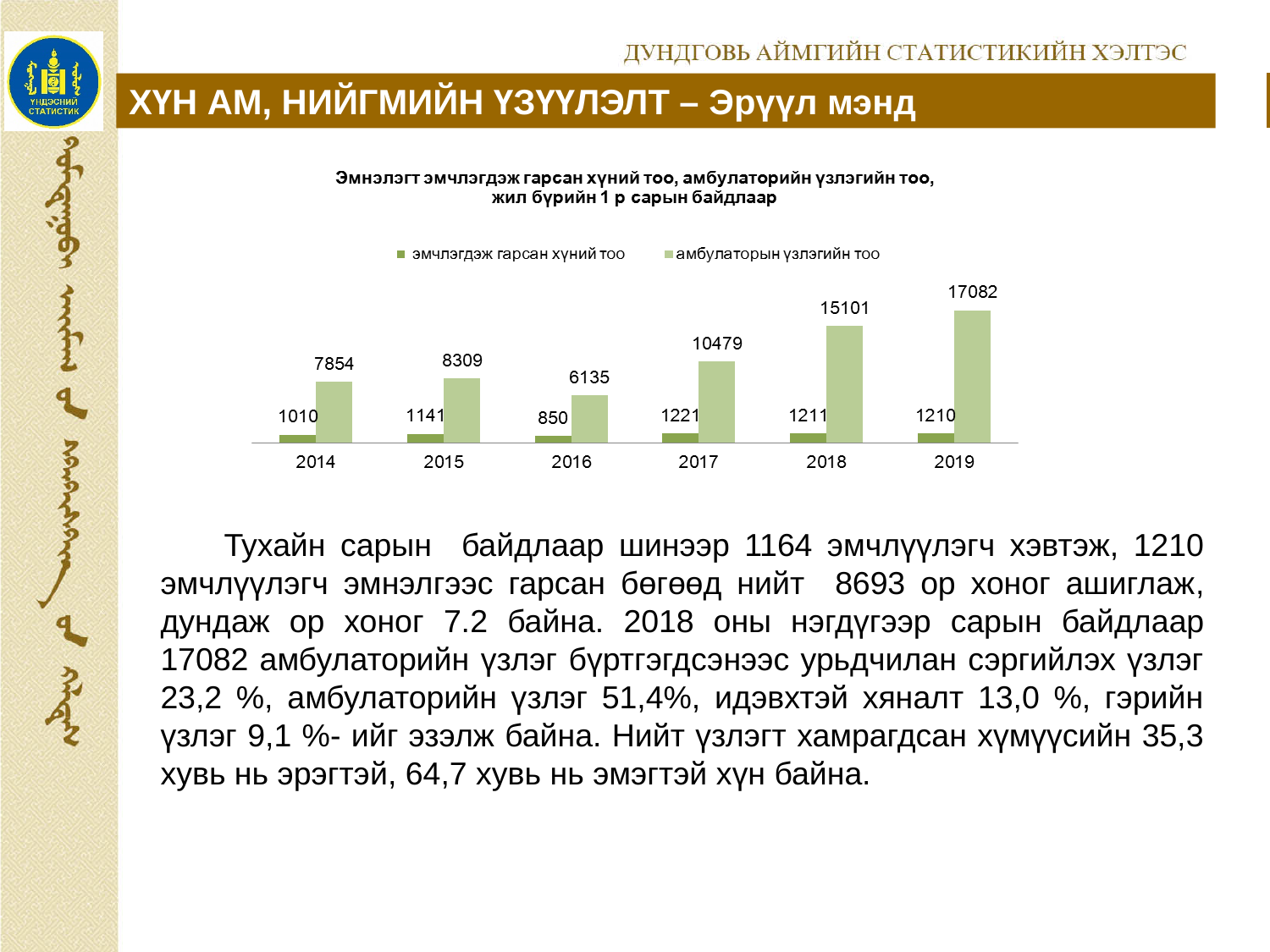
What is the value of амбулаторын үзлэгийн тоо for 2014? 7854 Which year has the lowest value for эмчлэгдэж гарсан хүний тоо? 2016 What is the value of амбулаторын үзлэгийн тоо for 2019? 17082 Does амбулаторын үзлэгийн тоо rise or fall from 2016 to 2019? Rise What is the difference between амбулаторын үзлэгийн тоо in 2019 and 2018? 1981 What kind of chart is shown on the slide? Bar chart How many years are shown on the x axis of the chart? 6 What is the value of эмчлэгдэж гарсан хүний тоо for 2016? 850 Which is larger: амбулаторын үзлэгийн тоо in 2015 or in 2016? 2015 How many series does the chart legend list? 2 What is the difference between эмчлэгдэж гарсан хүний тоо in 2017 and 2016? 371 Which year has the highest value for амбулаторын үзлэгийн тоо? 2019